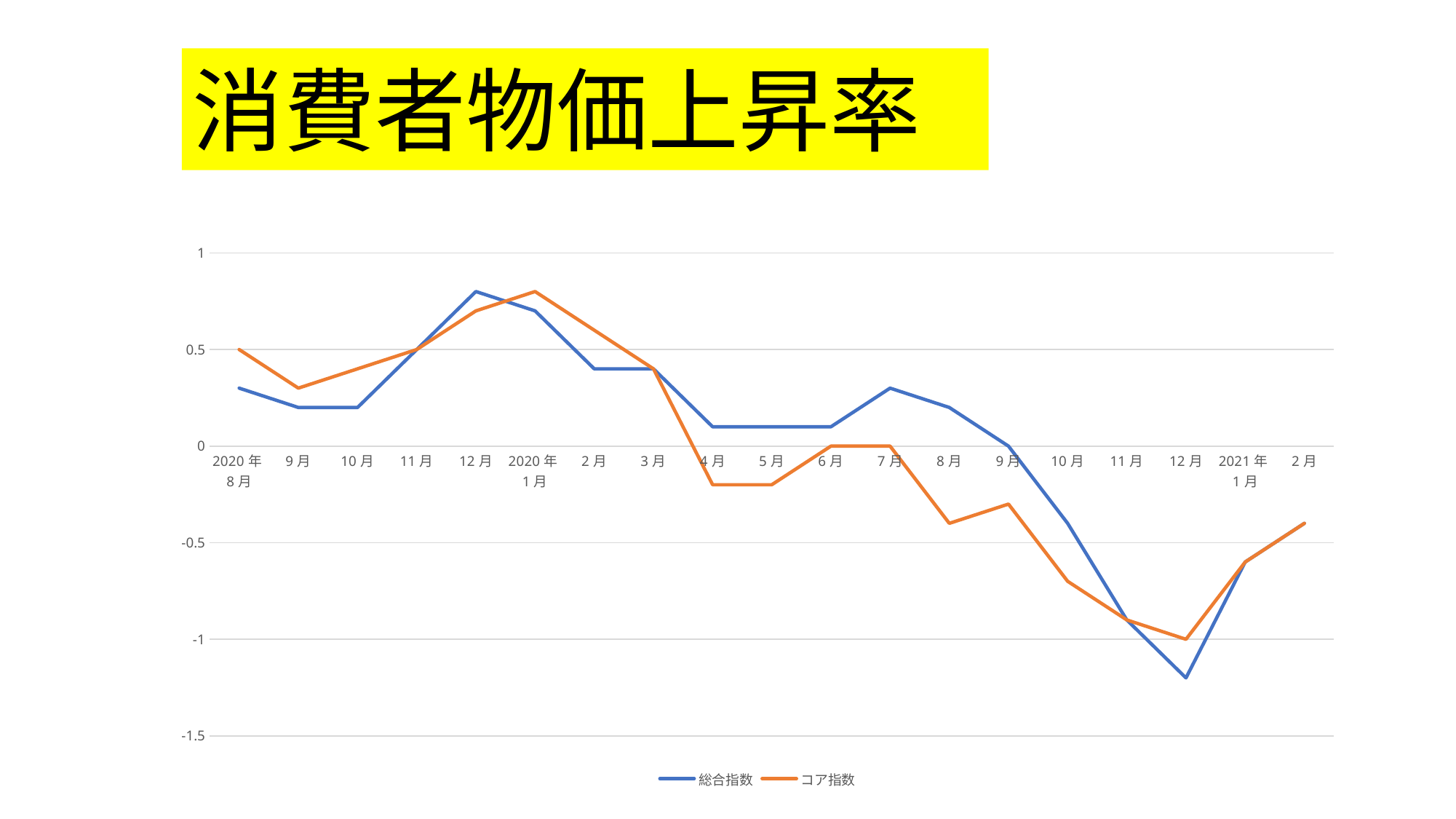
At which x-axis label does 総合指数 reach its lowest value? 12月 (the one just before 2021年1月) What is the value of コア指数 at the 12月 just before 2021年1月? -1 From 7月 to the 12月 just before 2021年1月, does 総合指数 rise or fall? fall Which series is drawn in orange according to the legend? コア指数 What kind of chart is shown on the slide? line chart What is the title of the slide above the chart? 消費者物価上昇率 What is the value of コア指数 at 2020年8月? 0.5 Is the value of コア指数 at 4月 greater or less than 0? less How many points (x-axis labels) are plotted along the x axis? 19 How many series does the legend list? 2 Is the value of 総合指数 at the 12月 just before 2021年1月 greater or less than -1? less At 4月, which series has the higher value, 総合指数 or コア指数? 総合指数